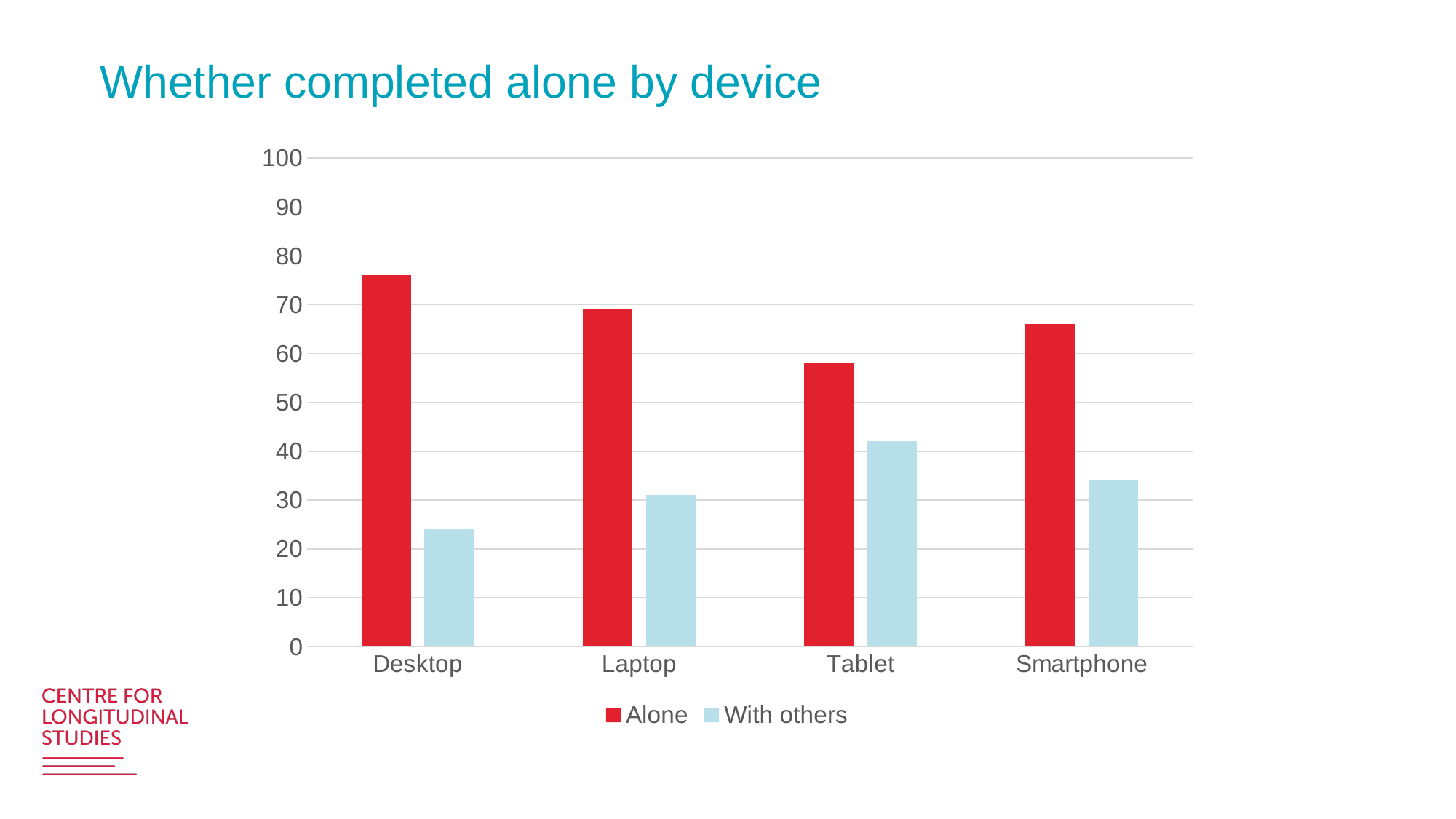
Which device has the lowest value for the With others series? Desktop Is the With others value for Desktop greater or less than 30? less Which is larger: the Alone value for Desktop or the Alone value for Tablet? Desktop What is the title of the chart? Whether completed alone by device How many series does the legend list? 2 Is the Alone value for Desktop greater or less than 70? greater Which device has the lowest value for the Alone series? Tablet How many device categories are shown on the x axis? 4 Which device has the highest value for the With others series? Tablet Which device has the highest value for the Alone series? Desktop What kind of chart is shown on the slide? bar chart